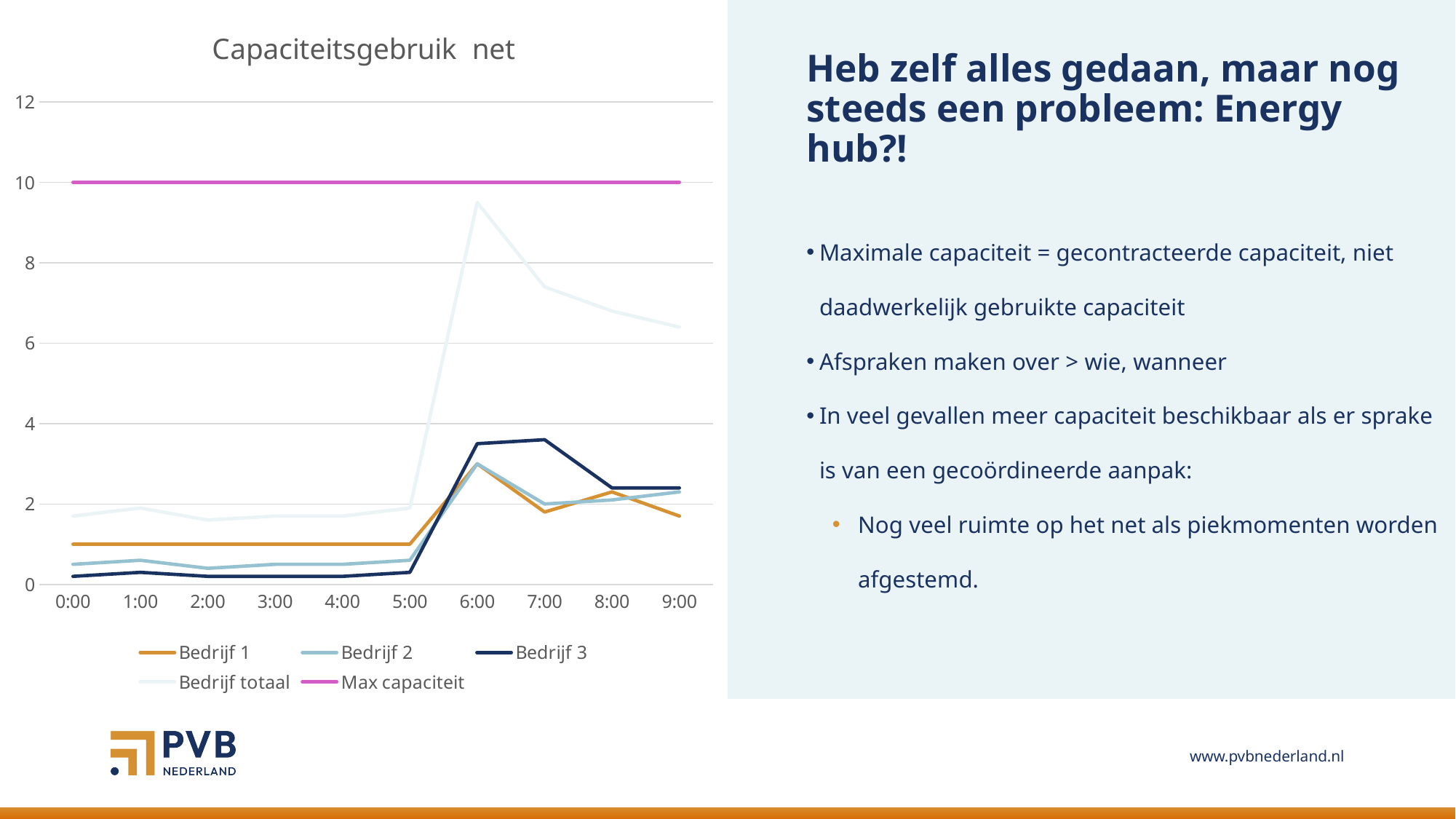
How many time points are shown on the x axis of the chart? 10 What kind of chart is shown on the slide? line chart Is the value for Bedrijf totaal at 6:00 greater or less than 8? greater What is the title of the chart? Capaciteitsgebruik net At 7:00, which is larger: Bedrijf 3 or Bedrijf 1? Bedrijf 3 Is the value for Bedrijf 3 at 7:00 greater or less than 4? less At which time does Bedrijf totaal reach its highest value? 6:00 What is the value of the Max capaciteit line? 10 Which series is drawn as a pink/magenta line? Max capaciteit Does the Bedrijf totaal line rise or fall from 6:00 to 9:00? fall How many series does the chart legend list? 5 Is the value for Bedrijf 1 at 9:00 greater or less than 2? less